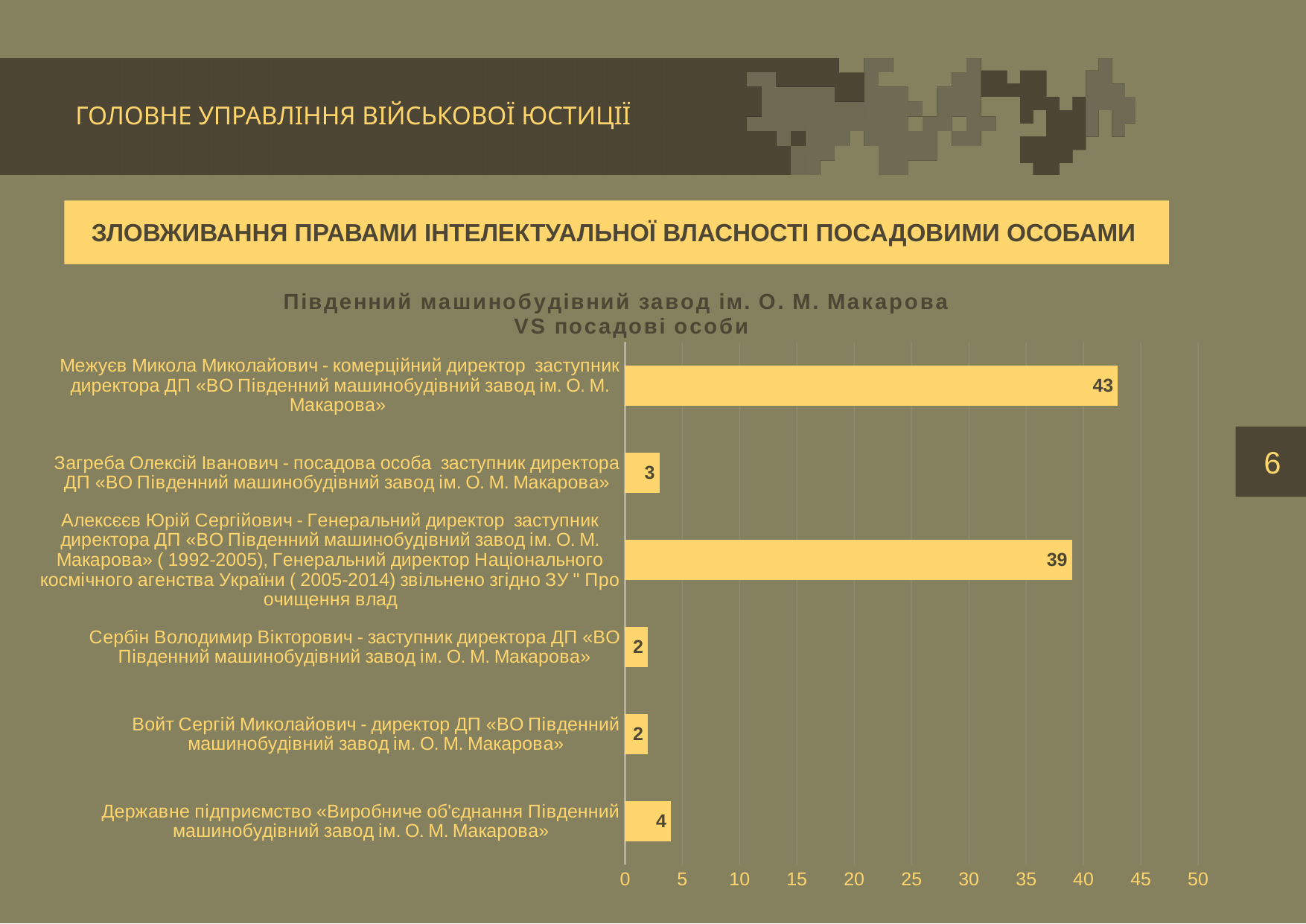
What is the value for Межуєв Микола Миколайович? 43 Is the value for Алексєєв Юрій Сергійович greater or less than 35? greater What is the value for Загреба Олексій Іванович? 3 How many categories are plotted in the chart? 6 Which category has the highest value? Межуєв Микола Миколайович What type of chart is shown on the slide? bar chart What is the title of the chart? Південний машинобудівний завод ім. О. М. Макарова VS посадові особи Which is larger, the value for Загреба Олексій Іванович or the value for Державне підприємство «Виробниче об'єднання Південний машинобудівний завод ім. О. М. Макарова»? Державне підприємство «Виробниче об'єднання Південний машинобудівний завод ім. О. М. Макарова» What is the difference between the values for Межуєв Микола Миколайович and Алексєєв Юрій Сергійович? 4 What is the value for Алексєєв Юрій Сергійович? 39 What is the value for Державне підприємство «Виробниче об'єднання Південний машинобудівний завод ім. О. М. Макарова»? 4 What is the value for Сербін Володимир Вікторович? 2